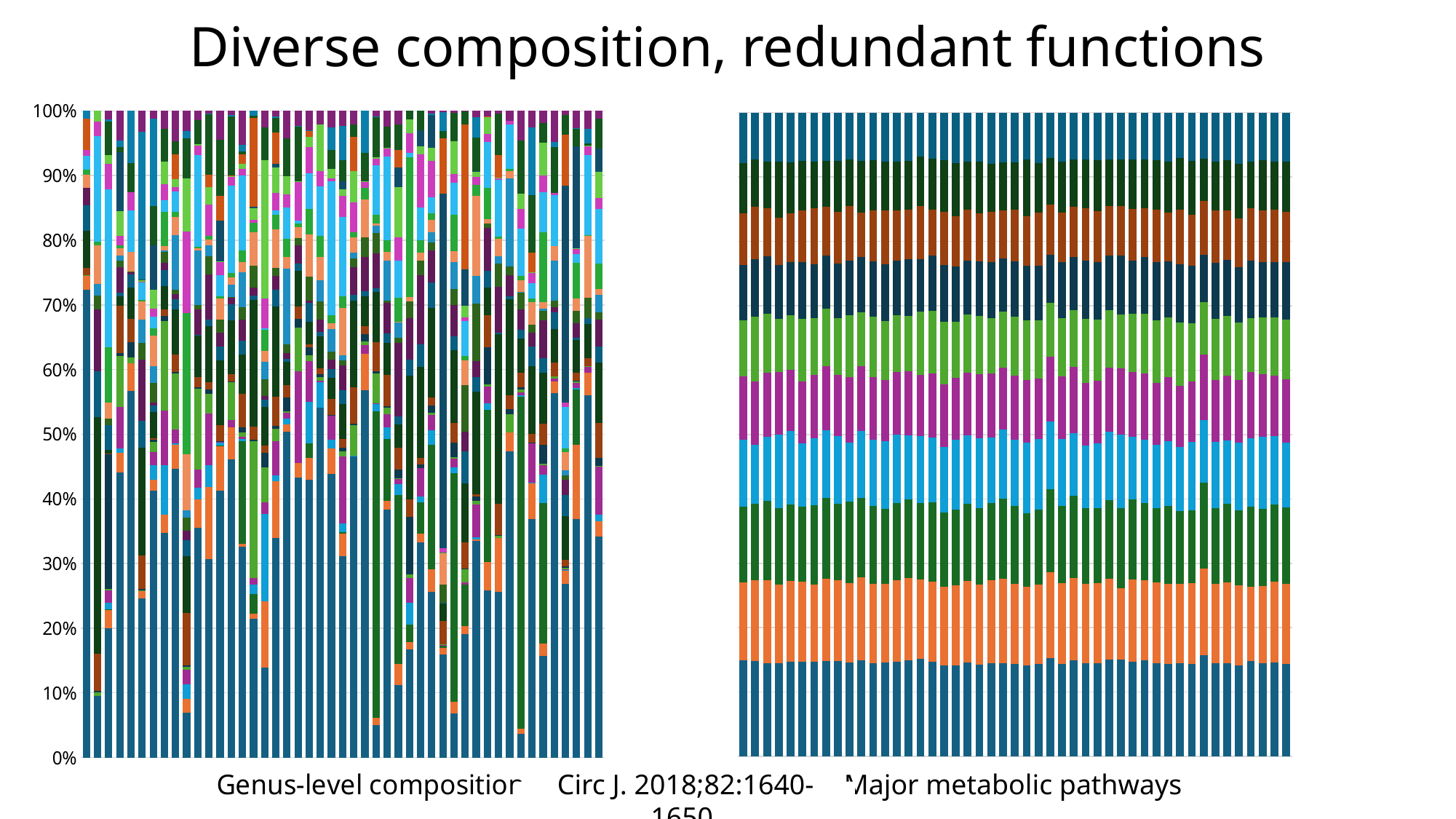
In the Major metabolic pathways chart, is the top of the bottom (dark blue) segment in each bar greater or less than 10%? greater Which chart shows more consistent segment proportions across its bars, Genus-level composition or Major metabolic pathways? Major metabolic pathways What kind of chart is the Major metabolic pathways chart on the right? Stacked bar chart What kind of chart is the Genus-level composition chart on the left? Stacked bar chart What is the title of the chart on the right side of the slide? Major metabolic pathways What is the highest value shown on the y axis of the Genus-level composition chart? 100% In the Major metabolic pathways chart, is the top of the bottom (dark blue) segment in each bar greater or less than 20%? less In the Major metabolic pathways chart, what is the total height that each stacked bar reaches? 100% In the Genus-level composition chart, is the bottom (dark blue) segment of the first bar on the left greater or less than 60%? greater What is the title of the chart on the left side of the slide? Genus-level composition